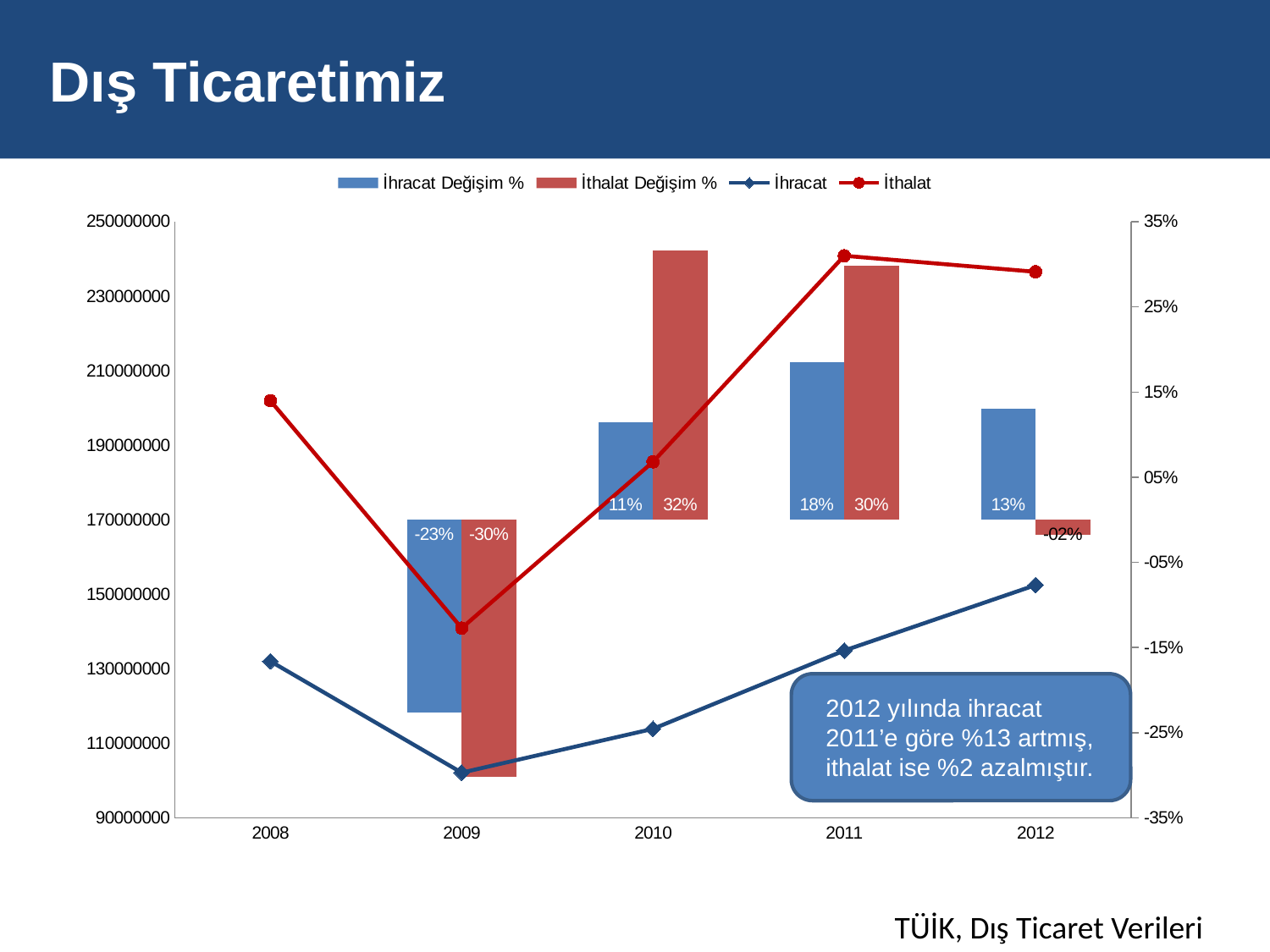
How many years are shown on the x axis? 5 What is the İhracat Değişim % value for 2010? 11% Which is larger in 2011, the İhracat Değişim % or the İthalat Değişim % value? İthalat Değişim % How many series does the legend list? 4 What is the İthalat Değişim % value for 2012? -02% What is the İhracat Değişim % value for 2011? 18% Is the İthalat line value for 2008 greater or less than 190000000? greater Does the İhracat line rise or fall from 2009 to 2012? rise In which year is the İthalat Değişim % bar highest? 2010 What is the İthalat Değişim % value for 2009? -30% In which year is the İhracat Değişim % bar lowest? 2009 What is the difference between the İthalat Değişim % and İhracat Değişim % values in 2010? 21%